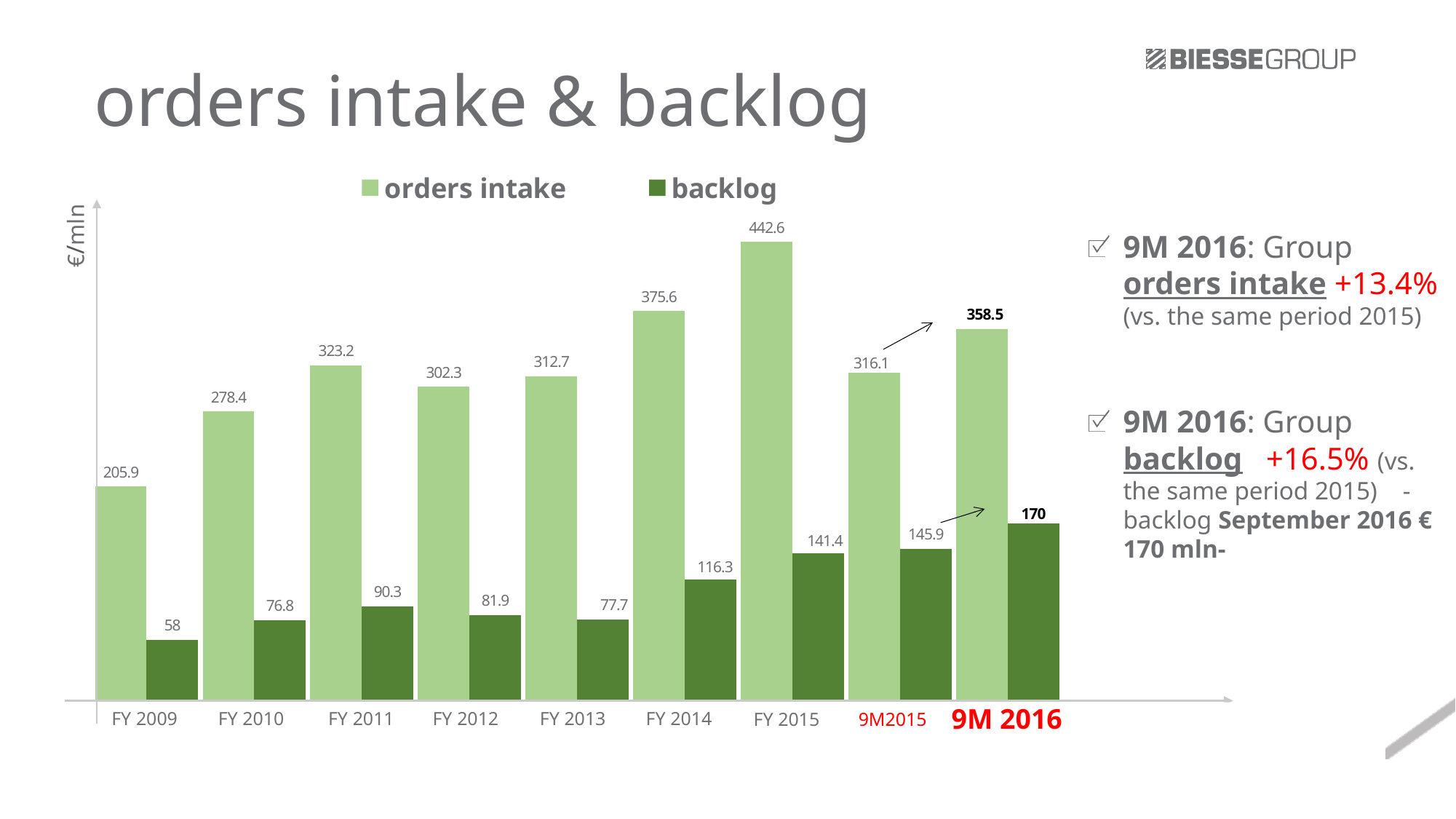
How many series does the legend list? 2 What kind of chart is shown on the slide? bar chart What is the orders intake value for FY 2015? 442.6 Which period has the highest orders intake? FY 2015 What is the backlog value for FY 2012? 81.9 What is the difference between orders intake in 9M 2016 and 9M2015? 42.4 Which period has the lowest backlog? FY 2009 Which is larger, the backlog for FY 2014 or the backlog for FY 2013? FY 2014 What is the backlog value for 9M 2016? 170 What is the orders intake value for FY 2009? 205.9 How many periods are shown on the x axis? 9 What unit is shown on the y axis label? €/mln